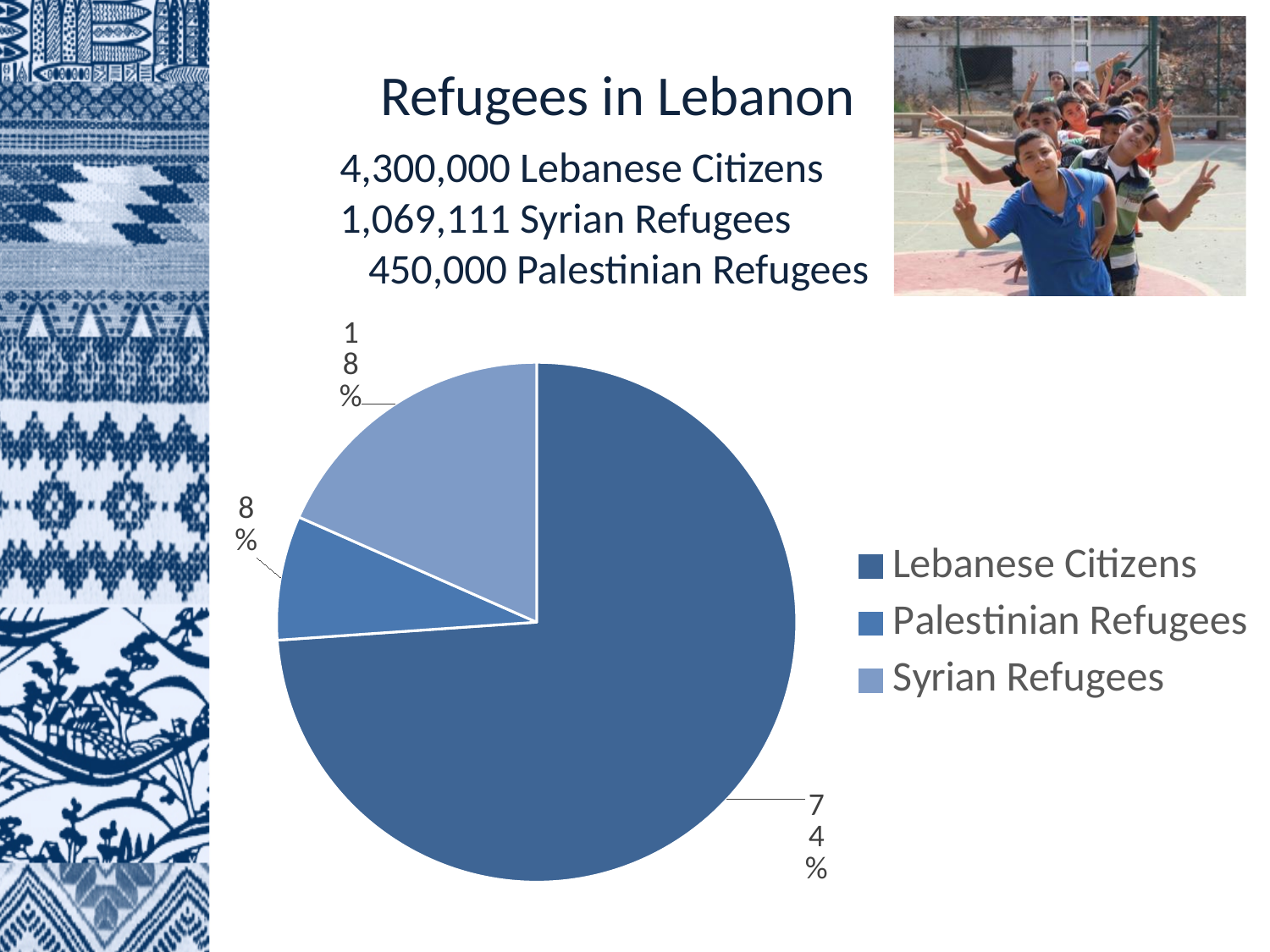
How many slices does the pie chart have? 3 What share of the pie chart is Syrian Refugees? 18% How many entries does the legend list? 3 What is the difference in percentage points between the Lebanese Citizens slice and the Syrian Refugees slice? 56 Which category has the largest slice of the pie chart? Lebanese Citizens Which category has the smallest slice of the pie chart? Palestinian Refugees What is the difference in percentage points between the Syrian Refugees slice and the Palestinian Refugees slice? 10 What share of the pie chart is Palestinian Refugees? 8% What is the title shown above the chart on the slide? Refugees in Lebanon Which slice is larger, Syrian Refugees or Palestinian Refugees? Syrian Refugees What kind of chart is shown on the slide? pie chart What share of the pie chart is Lebanese Citizens? 74%